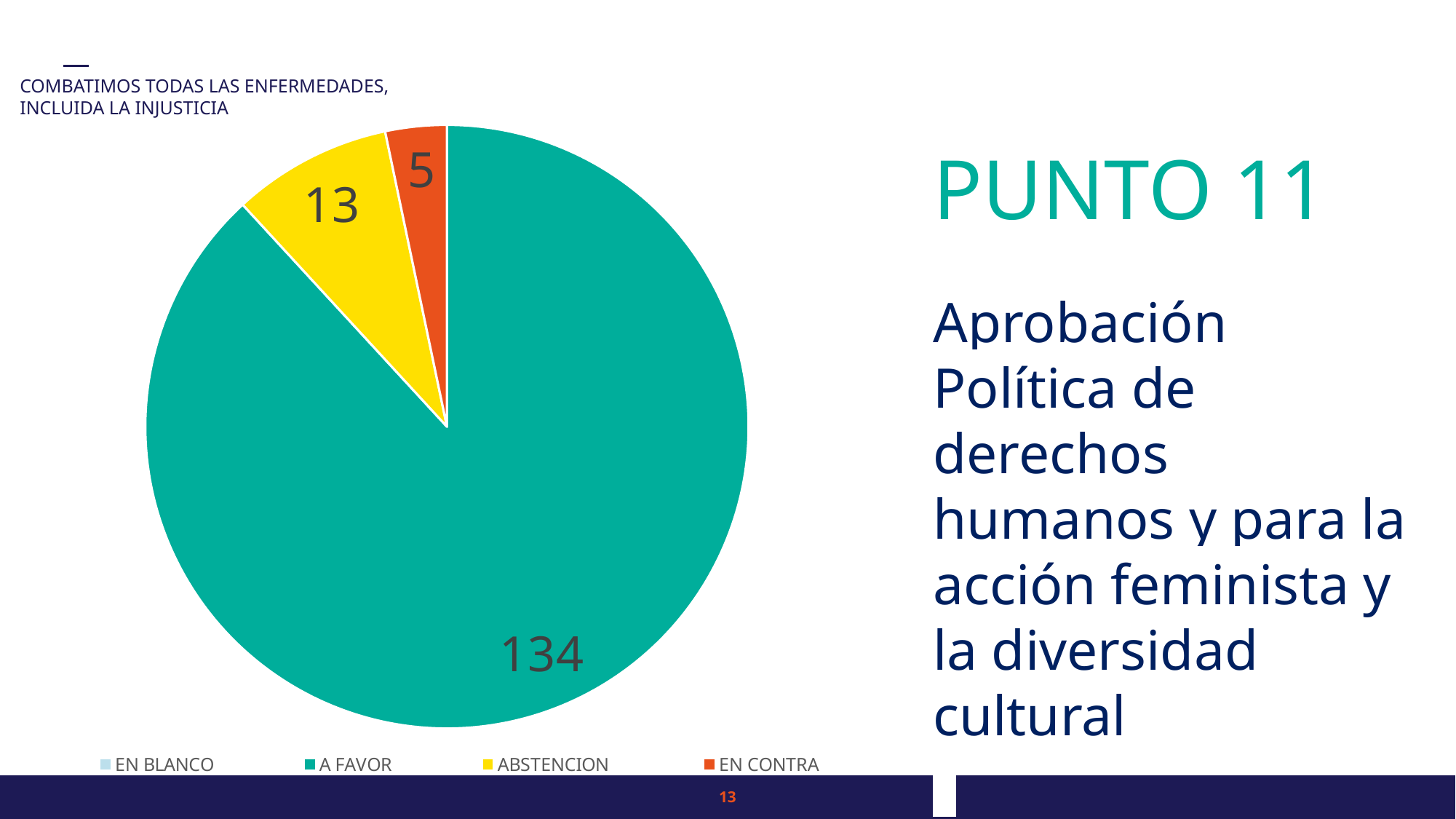
Which legend entry is shown in yellow? ABSTENCION What is the difference between the ABSTENCION value and the EN CONTRA value? 8 Which labelled category has the smallest slice in the pie chart? EN CONTRA What is the value for EN CONTRA in the pie chart? 5 Which category has the largest slice in the pie chart? A FAVOR What is the value for ABSTENCION in the pie chart? 13 How many categories does the legend of the pie chart list? 4 What is the value for A FAVOR in the pie chart? 134 Which is larger, ABSTENCION or EN CONTRA? ABSTENCION What is the difference between the A FAVOR value and the ABSTENCION value? 121 What colour is the A FAVOR slice in the pie chart? teal What type of chart is shown on the slide? pie chart